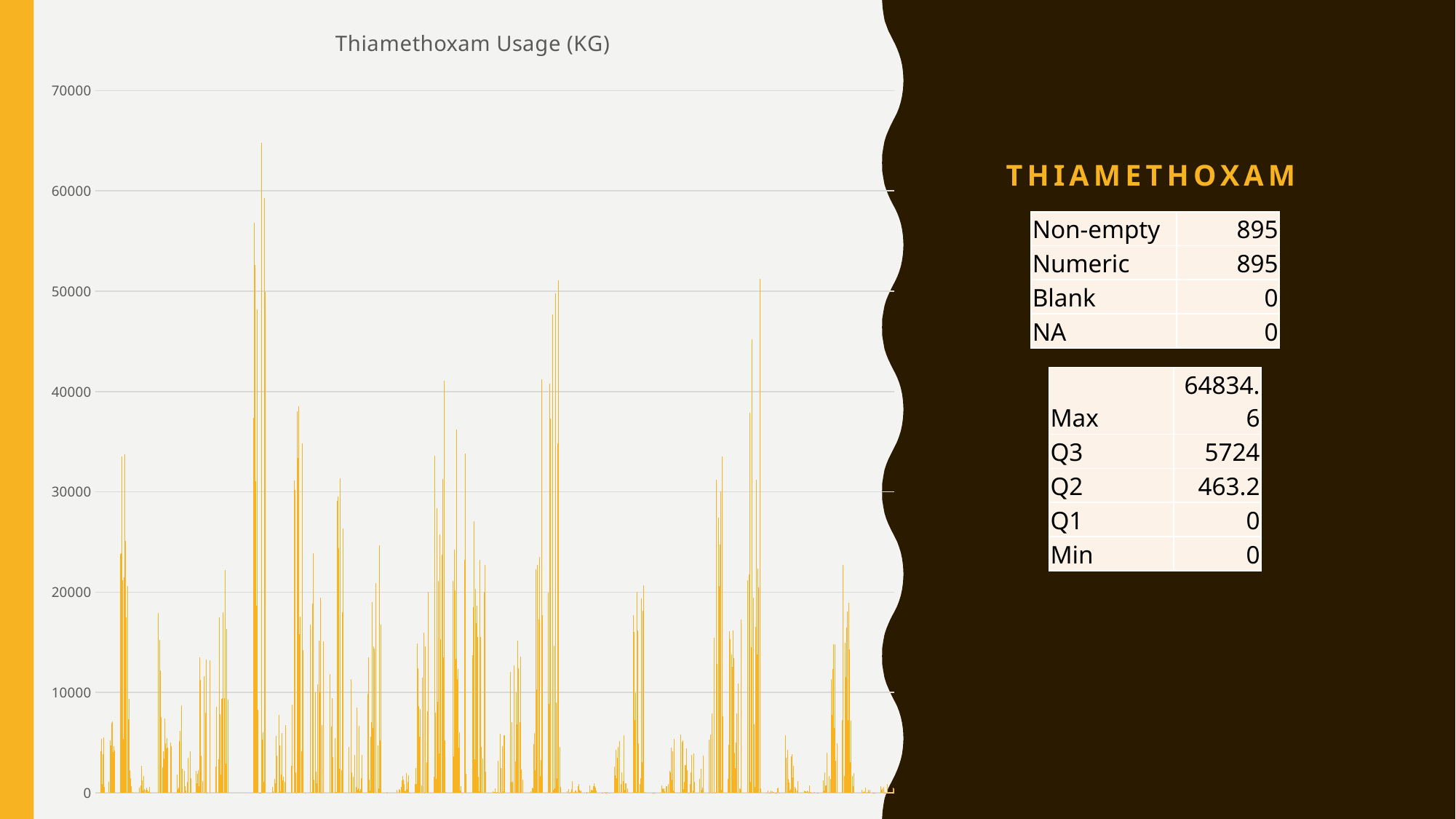
Is the tallest bar in the chart greater or less than 70000? less What is the title of the chart? Thiamethoxam Usage (KG) What is the highest value labelled on the chart's vertical axis? 70000 What kind of chart is shown on the slide? bar chart Is the lowest value labelled on the vertical axis 0 or 10000? 0 Is the tallest bar in the chart greater or less than 60000? greater